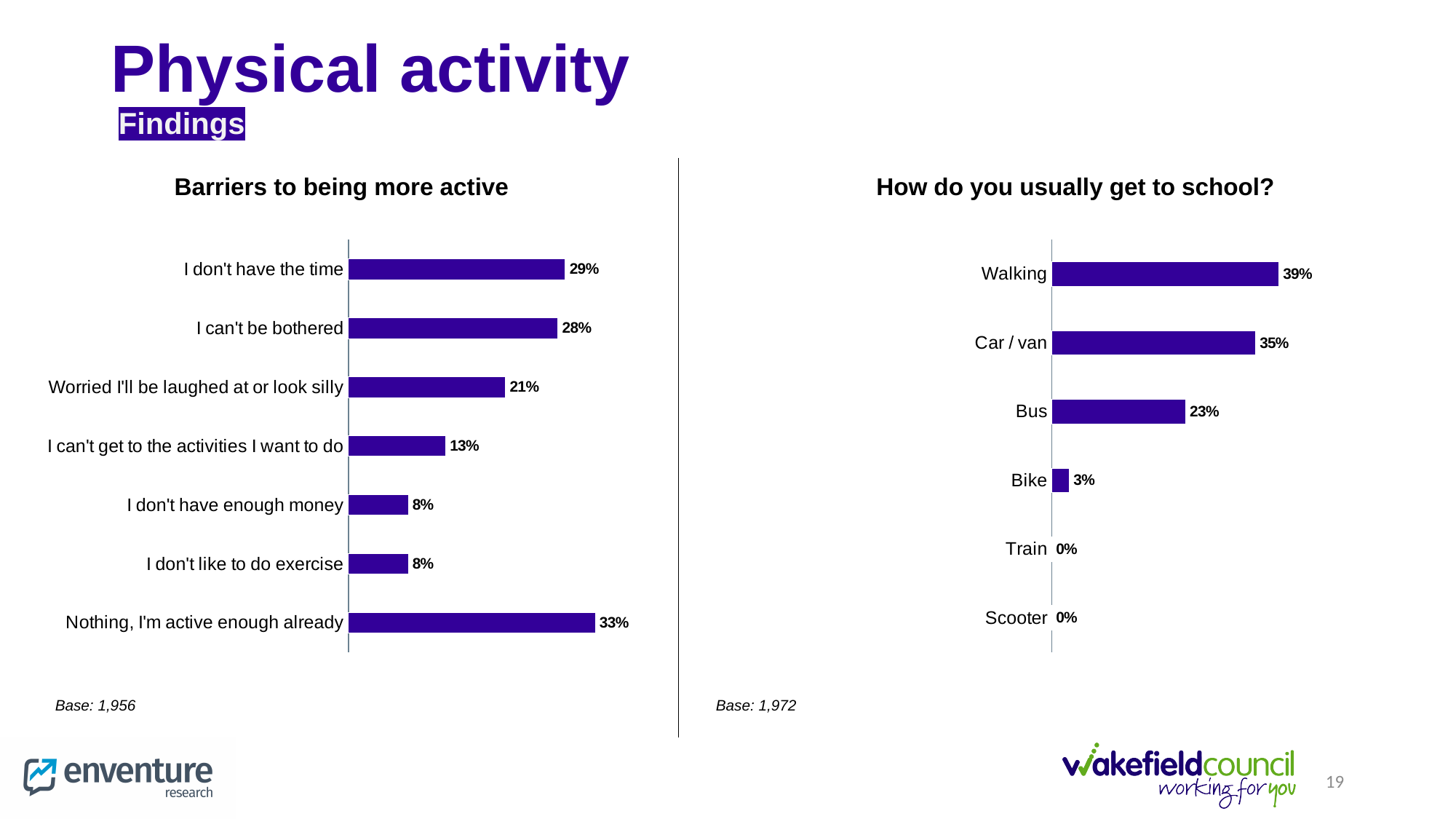
In the 'How do you usually get to school?' chart, how many categories are shown? 6 In the 'How do you usually get to school?' chart, what is the value for 'Bus'? 23% What kind of chart is the 'How do you usually get to school?' chart? Bar chart In the 'Barriers to being more active' chart, how many categories are shown? 7 In the 'Barriers to being more active' chart, what is the difference between 'I can't be bothered' and 'I can't get to the activities I want to do'? 15% In the 'How do you usually get to school?' chart, what is the difference between 'Walking' and 'Car / van'? 4% In the 'How do you usually get to school?' chart, which is larger, 'Car / van' or 'Bus'? Car / van What is the base (number of respondents) shown under the 'Barriers to being more active' chart? 1,956 In the 'Barriers to being more active' chart, what is the value for 'I don't have the time'? 29% In the 'How do you usually get to school?' chart, which category has the highest value? Walking In the 'Barriers to being more active' chart, what is the value for 'Worried I'll be laughed at or look silly'? 21% In the 'Barriers to being more active' chart, which category has the highest value? Nothing, I'm active enough already